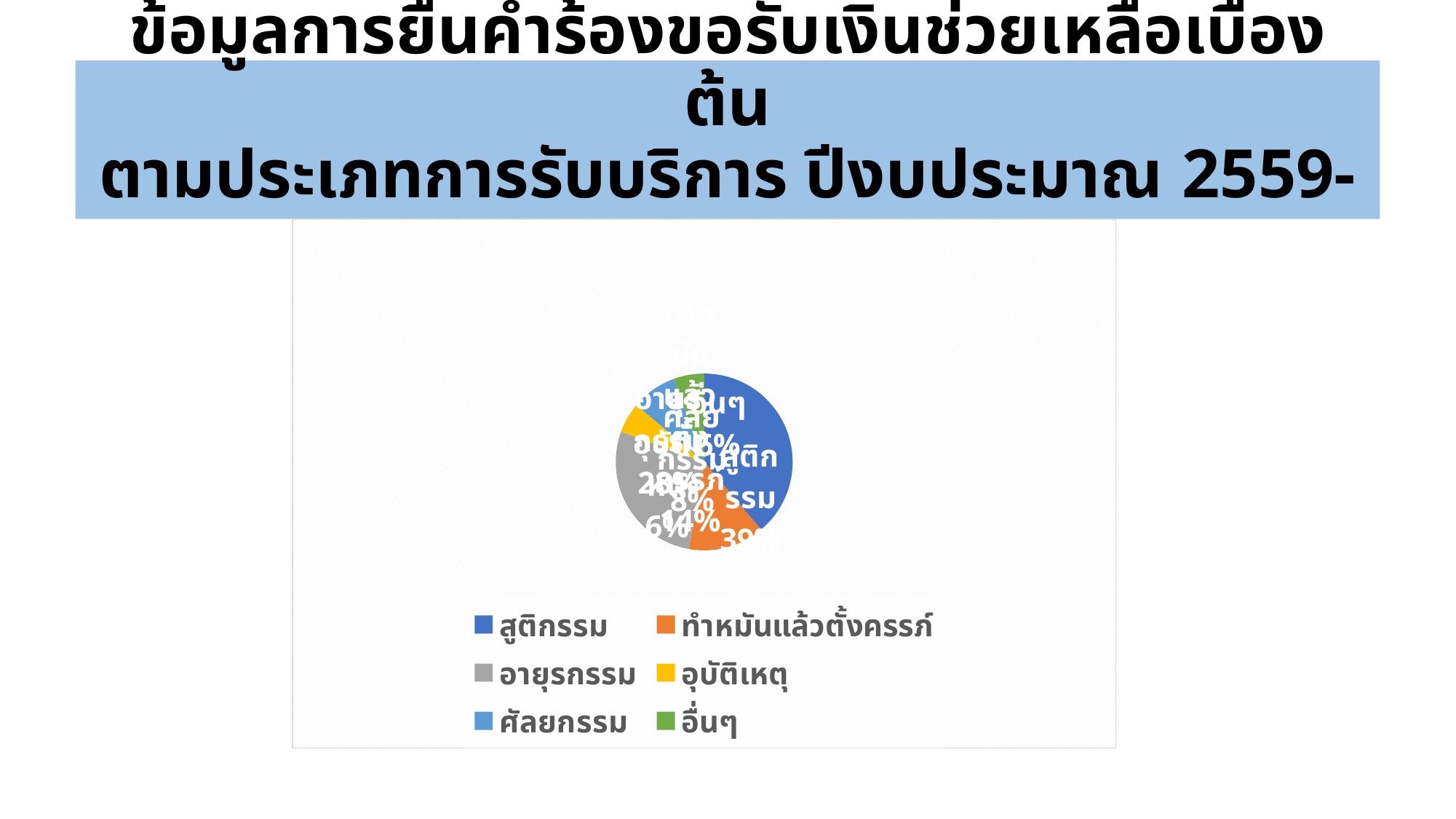
Which slice is larger, สูติกรรม or อุบัติเหตุ? สูติกรรม Which slice is larger, อายุรกรรม or ศัลยกรรม? อายุรกรรม How many entries does the legend list? 6 What kind of chart is shown on the slide? pie chart Which category is shown in green in the legend? อื่นๆ How many categories does the pie chart have? 6 Which category has the largest slice of the pie? สูติกรรม Which slice is larger, อายุรกรรม or ทำหมันแล้วตั้งครรภ์? อายุรกรรม What colour represents สูติกรรม in the pie chart? blue